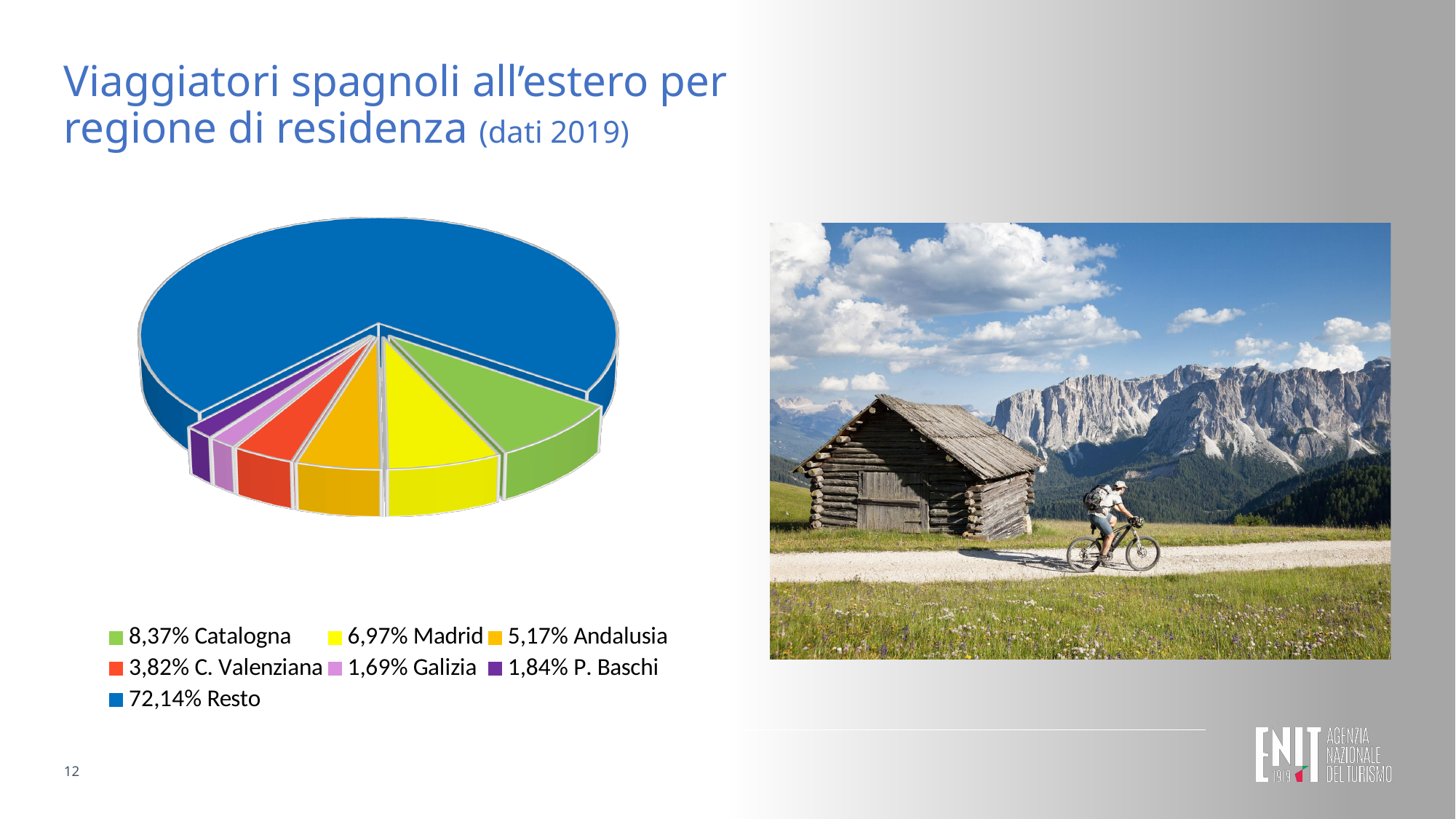
What share of the pie does Madrid represent? 6,97% What is the value shown for C. Valenziana? 3,82% Which category has the largest slice of the pie? Resto What is the value shown for Andalusia? 5,17% What share of the pie does Catalogna represent? 8,37% What share of the pie does Resto represent? 72,14% Which category has the smallest slice of the pie? Galizia Which is larger, the share for P. Baschi or the share for Galizia? P. Baschi What is the difference in percentage points between Catalogna and Madrid? 1,40 How many categories are shown in the pie chart? 7 What is the value shown for Galizia? 1,69% What kind of chart is shown on the slide? Pie chart